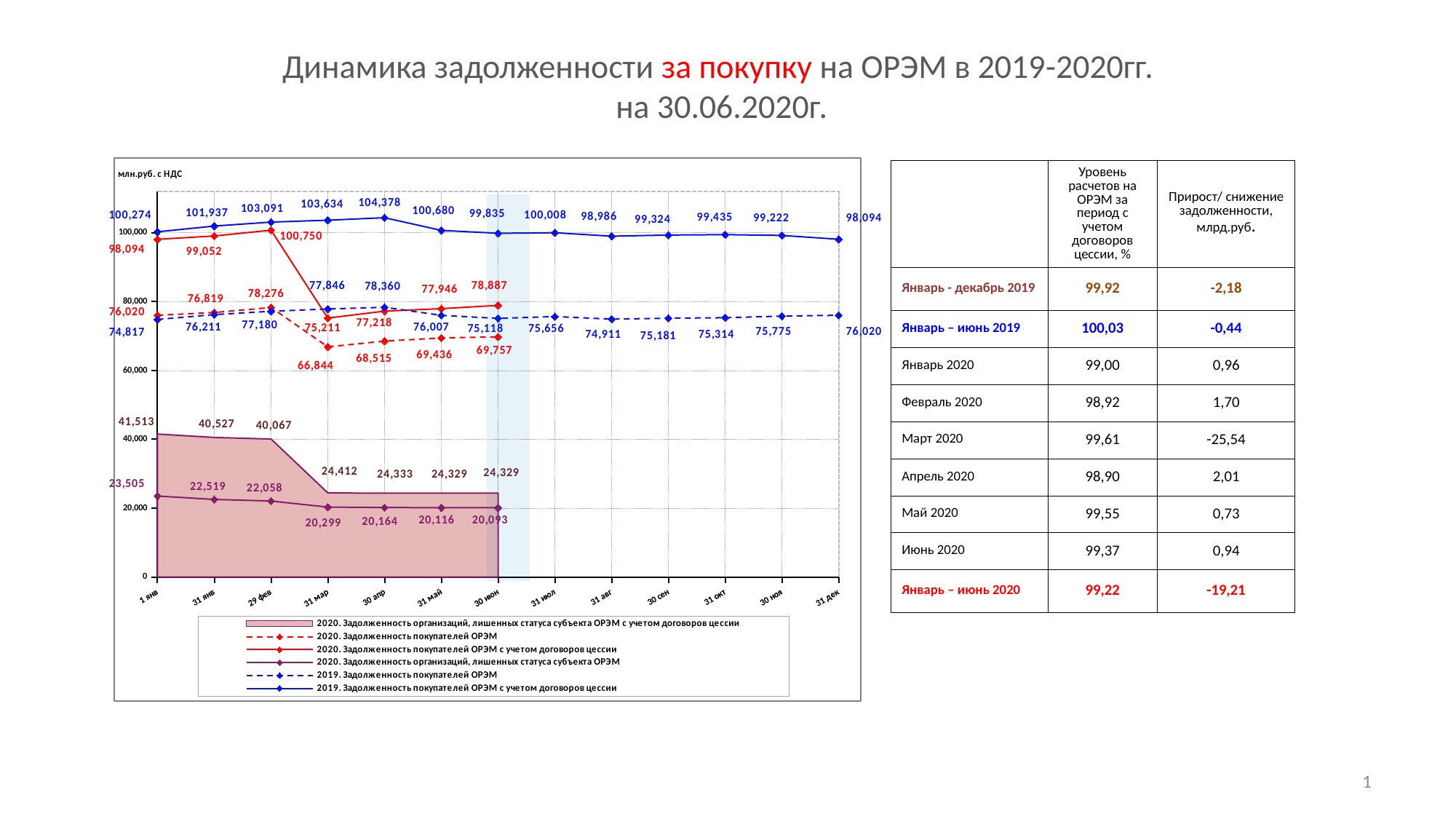
What is the value of the series '2019. Задолженность покупателей ОРЭМ' at 31 дек? 76,020 What is the value of the shaded area series '2020. Задолженность организаций, лишенных статуса субъекта ОРЭМ с учетом договоров цессии' at 1 янв? 41,513 At which date does the series '2019. Задолженность покупателей ОРЭМ с учетом договоров цессии' reach its highest value? 30 апр What kind of chart is shown on the slide? combination area and line chart What is the value of the series '2019. Задолженность покупателей ОРЭМ с учетом договоров цессии' at 30 апр? 104,378 Does the series '2020. Задолженность организаций, лишенных статуса субъекта ОРЭМ' rise or fall from 1 янв to 30 июн? fall At which date is the series '2020. Задолженность покупателей ОРЭМ' at its lowest? 31 мар By how much does the series '2020. Задолженность покупателей ОРЭМ с учетом договоров цессии' drop from 29 фев to 31 мар? 25,539 What is the value of the series '2020. Задолженность покупателей ОРЭМ с учетом договоров цессии' at 30 июн? 78,887 How many series does the chart legend list? 6 At 1 янв, which is larger: the 2019 or the 2020 value of 'Задолженность покупателей ОРЭМ с учетом договоров цессии'? 2019 How many dates are marked on the x axis of the chart? 13